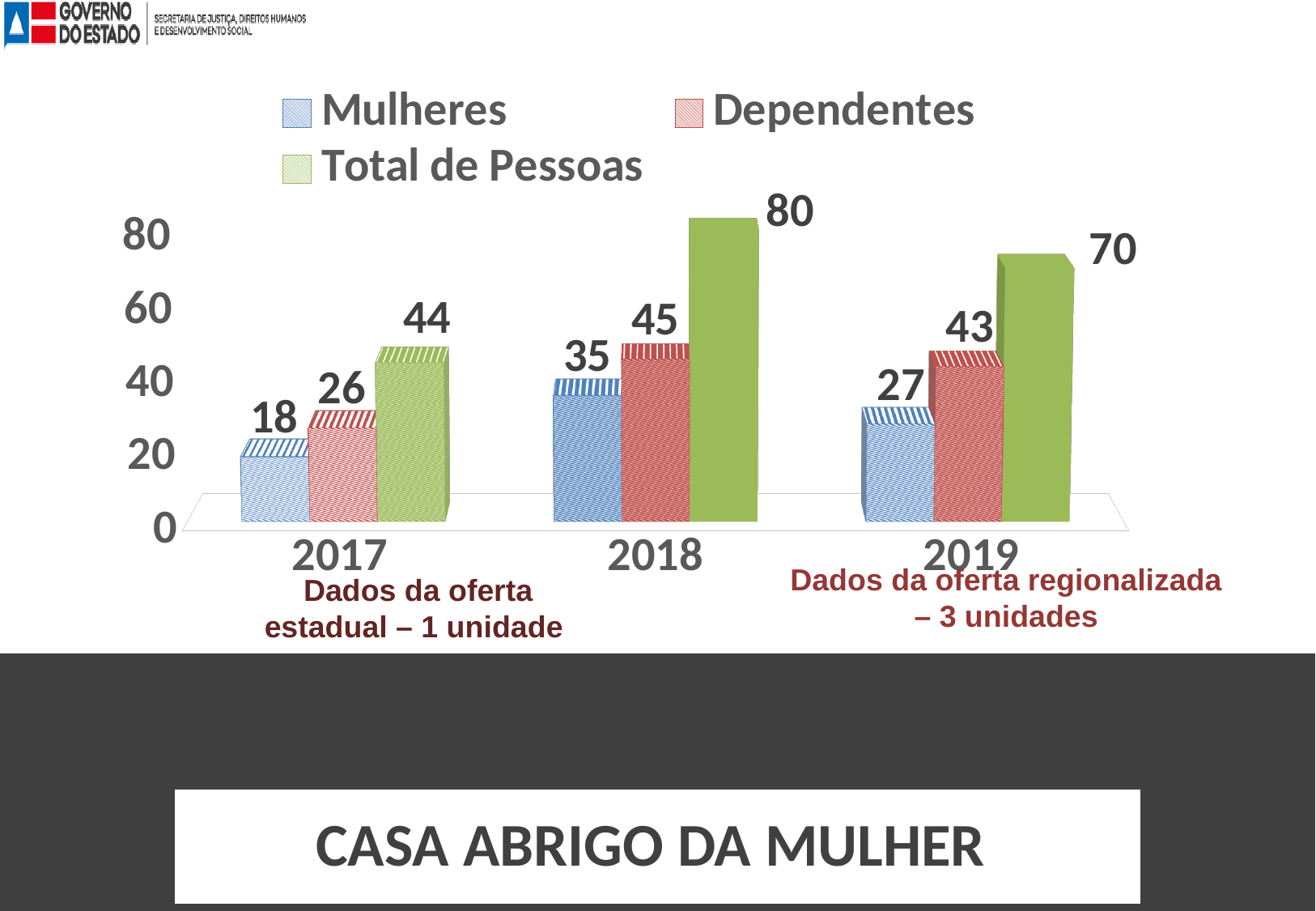
In which year is Total de Pessoas highest? 2018 What is the value for Dependentes in 2018? 45 Which series is shown in green? Total de Pessoas Which is larger: Dependentes in 2019 or Mulheres in 2018? Dependentes in 2019 In which year is Mulheres lowest? 2017 What is the value for Mulheres in 2017? 18 How many series does the legend list? 3 What kind of chart is shown? bar chart How many years are shown on the x axis? 3 What is the value for Total de Pessoas in 2019? 70 Is the value for Total de Pessoas in 2018 greater or less than 60? greater What is the difference between Total de Pessoas in 2018 and in 2017? 36